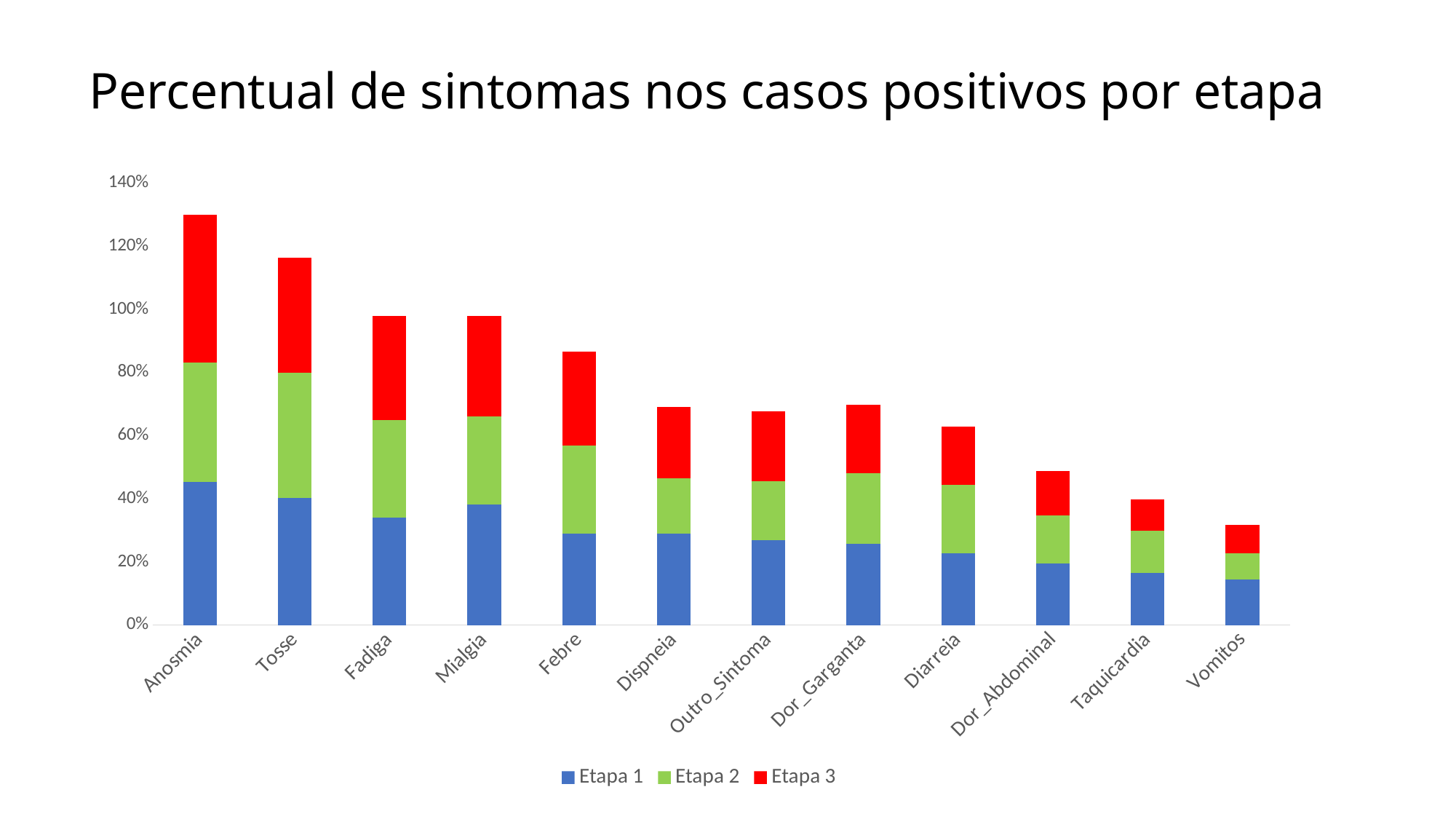
How many symptom categories are shown on the x axis? 12 Is the Etapa 1 value for Anosmia greater or less than 40%? greater Is the total stacked value for Vomitos greater or less than 40%? less Is the total stacked value for Anosmia greater or less than 120%? greater Which symptom has the lowest total stacked bar? Vomitos Do the total stacked values generally rise or fall from left to right along the x axis? fall Which symptom has the highest total stacked bar? Anosmia Which has the larger total stacked bar, Diarreia or Dor_Abdominal? Diarreia How many series does the legend list? 3 What kind of chart is shown on the slide? Stacked bar chart What colour represents Etapa 3 in the legend? Red